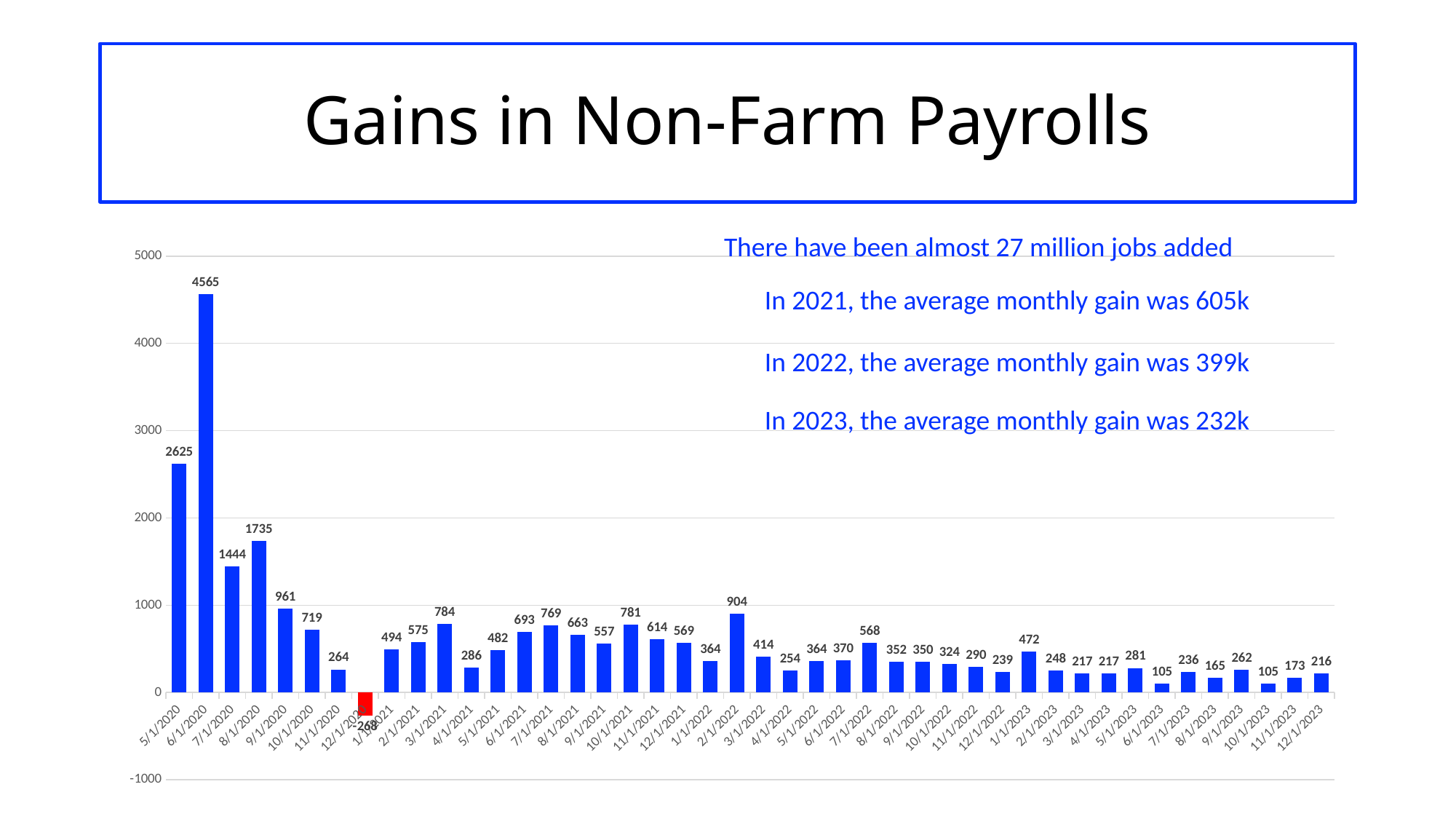
Which month has the highest value in the chart? 6/1/2020 What is the title of the chart? Gains in Non-Farm Payrolls What is the difference between the values for 9/1/2020 and 10/1/2020? 242 Which month has the lowest value in the chart? 12/1/2020 What is the value for 6/1/2023? 105 What is the difference between the values for 6/1/2020 and 5/1/2020? 1940 What is the value for 6/1/2020? 4565 What is the value for 2/1/2022? 904 How many months (bars) are plotted in the chart? 44 What kind of chart is shown on the slide? bar chart Which is larger, the value for 7/1/2021 or the value for 9/1/2021? 7/1/2021 What is the value for 1/1/2023? 472